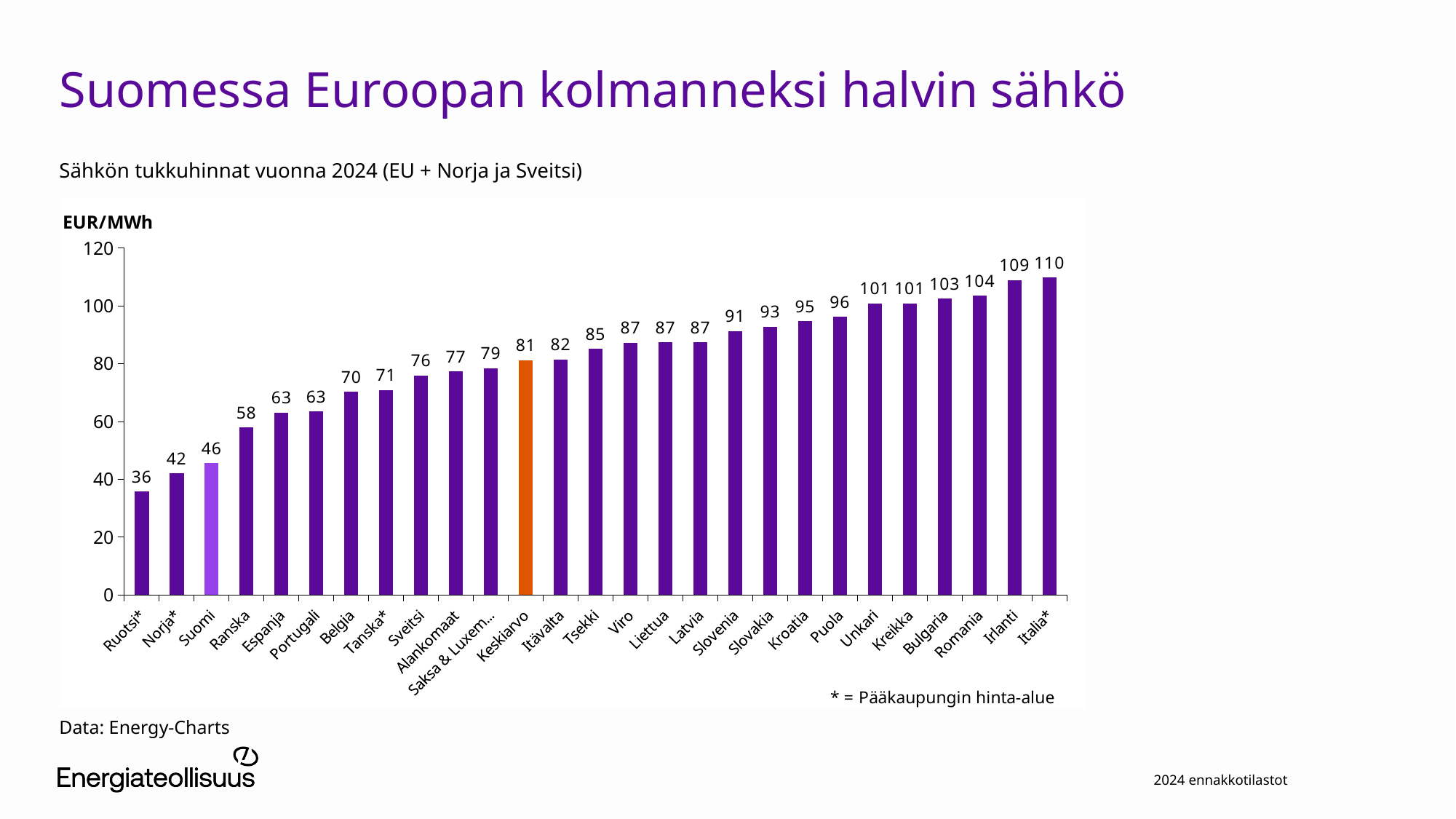
What is the difference between the values for Italia* and Suomi? 64 What unit is shown on the y axis of the chart? EUR/MWh Which category has the highest value? Italia* Which is larger, the value for Puola or the value for Kroatia? Puola What is the value for Keskiarvo? 81 What is the value for Suomi? 46 Which category has the lowest value? Ruotsi* What is the value for Irlanti? 109 Do the values rise or fall from left to right along the x axis? Rise How many bars are shown in the chart? 27 What is the difference between the values for Keskiarvo and Suomi? 35 What kind of chart is shown on the slide? Bar chart